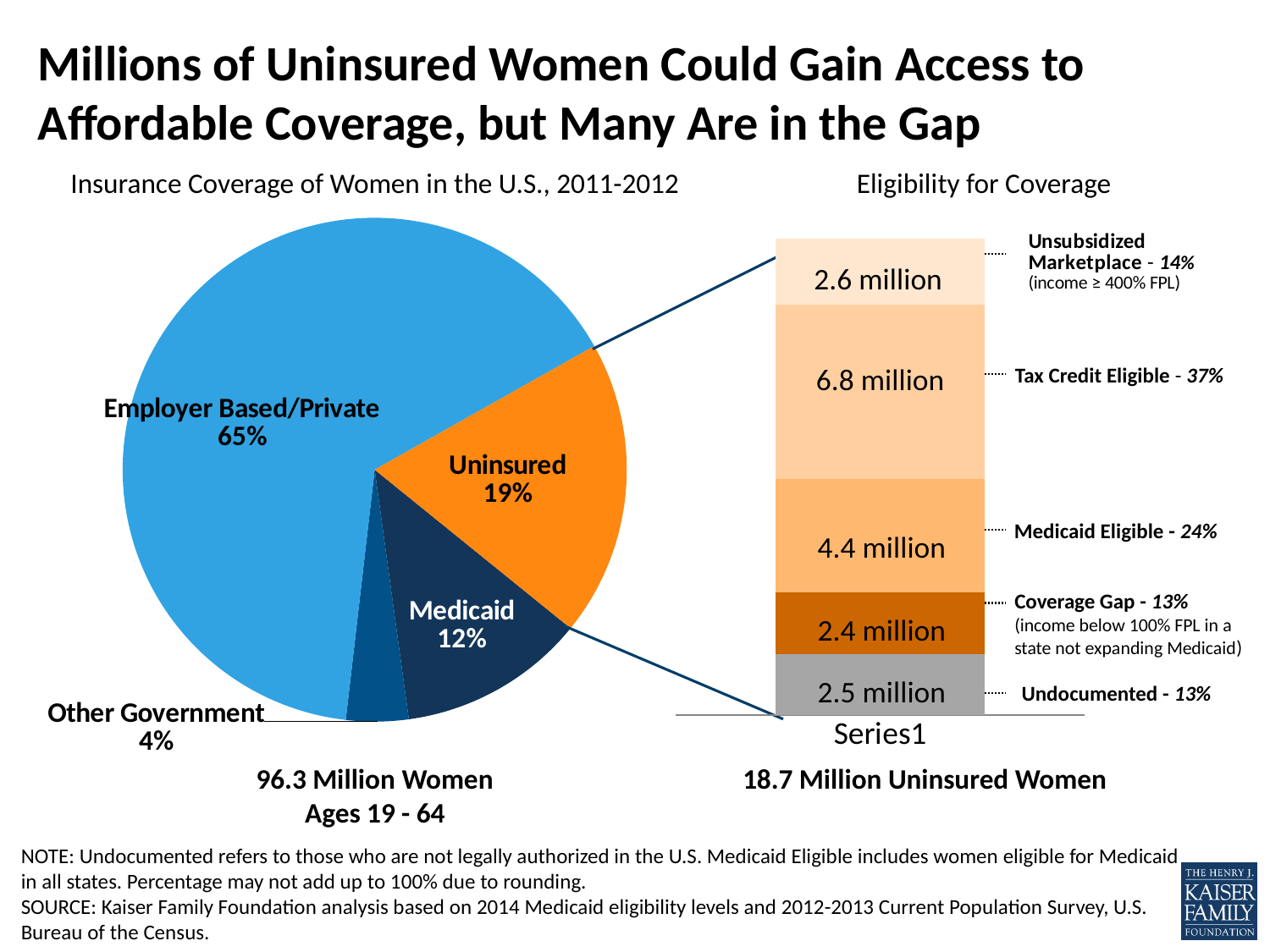
What type of chart is the Eligibility for Coverage chart on the right? Stacked bar chart In the Eligibility for Coverage chart, which segment is the largest? Tax Credit Eligible In the Eligibility for Coverage chart, what is the difference in millions between the Tax Credit Eligible and Medicaid Eligible segments? 2.4 million How many categories does the pie chart on the left show? 4 In the Eligibility for Coverage chart, how many uninsured women are in the Coverage Gap? 2.4 million In the Eligibility for Coverage chart, how many uninsured women are Tax Credit Eligible? 6.8 million In the pie chart on the left, which category has the smallest share? Other Government In the pie chart on the left, how many percentage points larger is the Uninsured share than the Medicaid share? 7 In the Eligibility for Coverage chart, which is larger: the Unsubsidized Marketplace segment or the Undocumented segment? Unsubsidized Marketplace In the pie chart on the left, which category has the largest share? Employer Based/Private In the pie chart on the left, what percentage of women are Uninsured? 19% In the pie chart on the left, what share of women have Employer Based/Private coverage? 65%